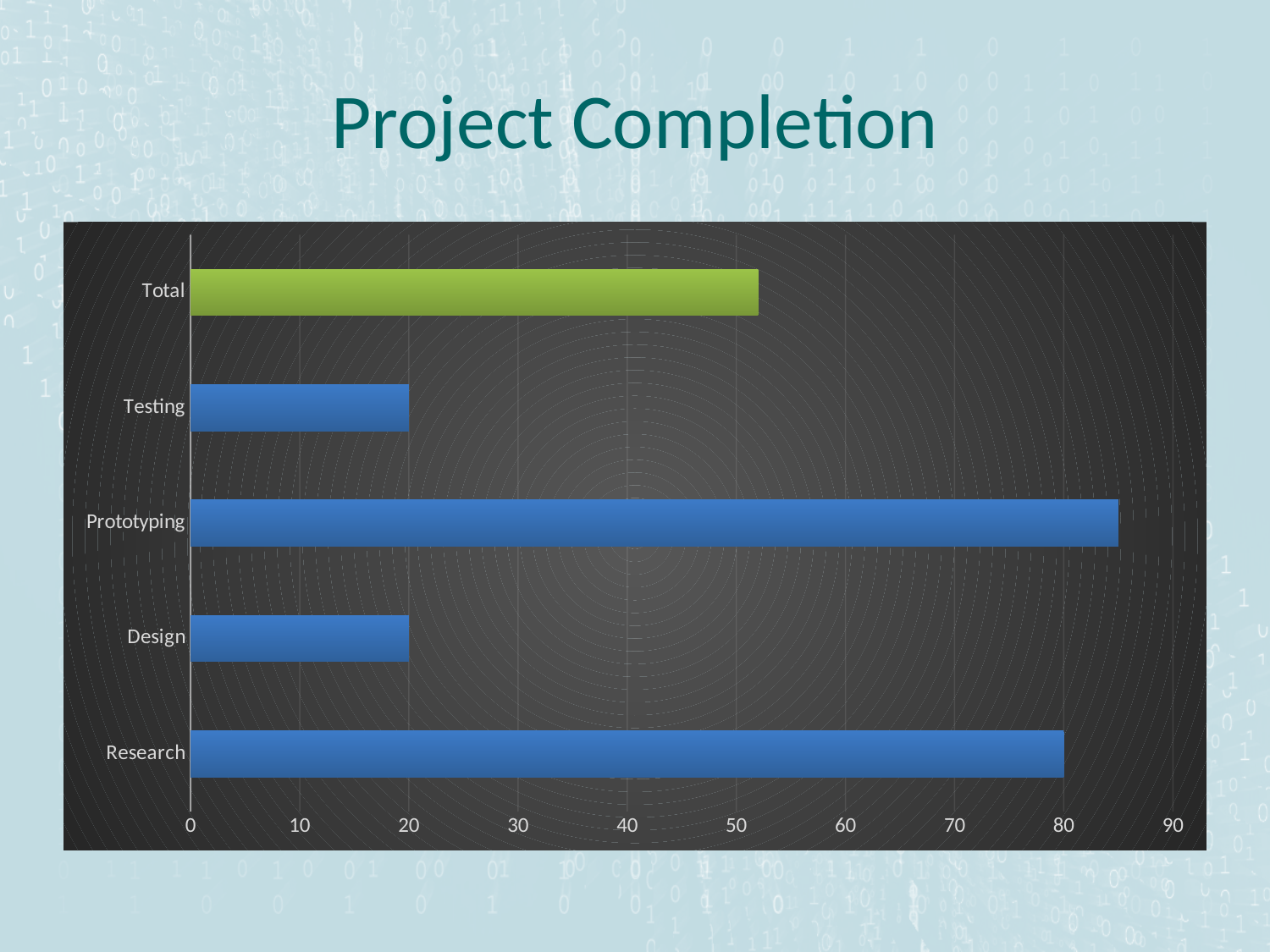
What is the value for Research? 80 What kind of chart is shown on the slide? bar chart Which is larger, the value for Research or the value for Prototyping? Prototyping Which is larger, the value for Total or the value for Testing? Total Which category has the highest value? Prototyping Is the value for Total greater or less than 40? greater Is the value for Total greater or less than 60? less What is the title of the slide? Project Completion What is the difference between the values for Research and Design? 60 How many categories are plotted on the chart? 5 What is the value for Design? 20 Is the value for Prototyping greater or less than 80? greater